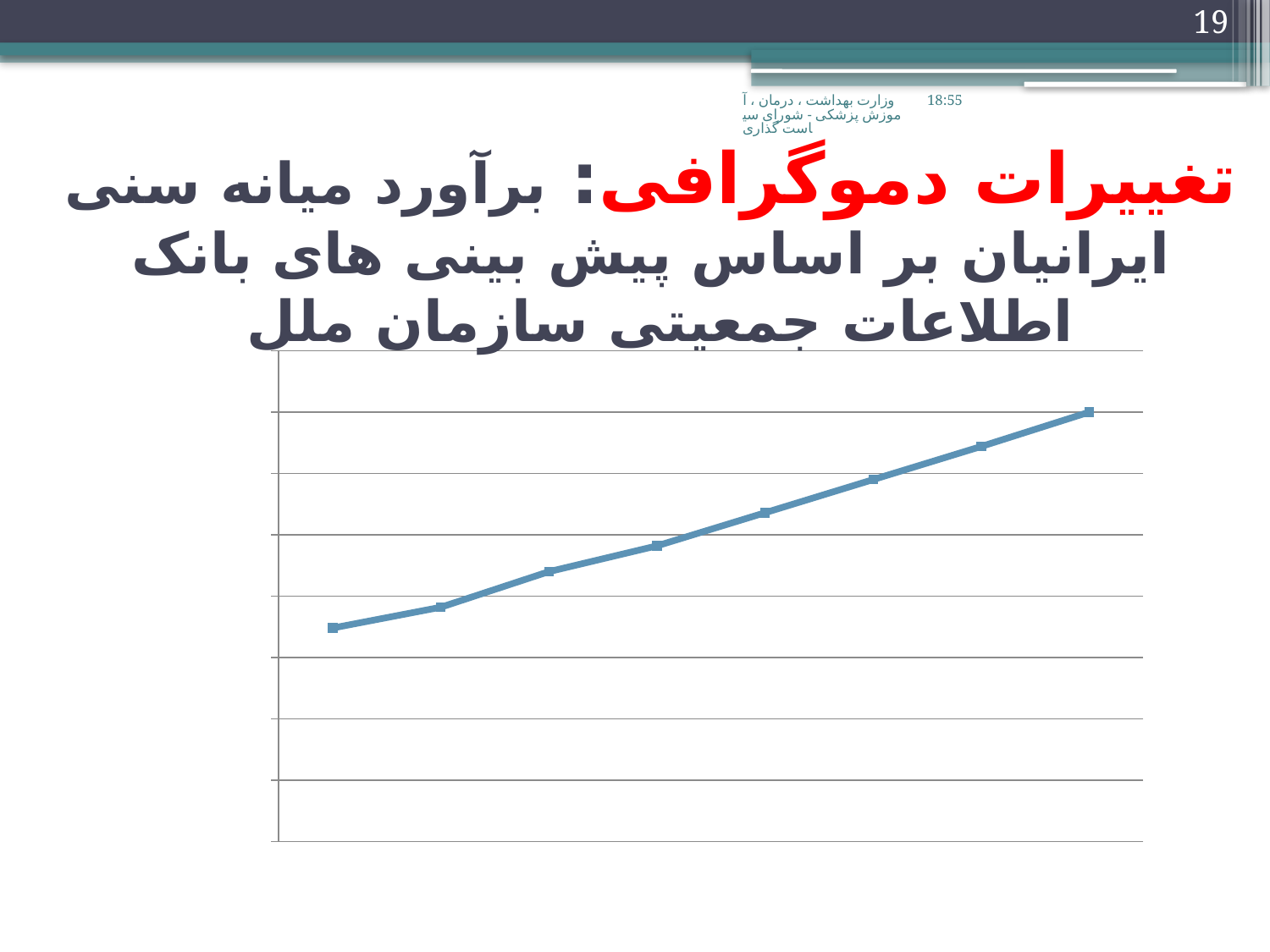
Which point on the line is the highest? the last (rightmost) point How many lines (series) are plotted on the chart? 1 Do the values rise or fall from left to right along the x axis? rise Is the first (leftmost) point or the last (rightmost) point higher? the last (rightmost) point What colour is the plotted line? blue How many data points are plotted on the line? 8 Which point on the line is the lowest? the first (leftmost) point What kind of chart is shown on the slide? line chart